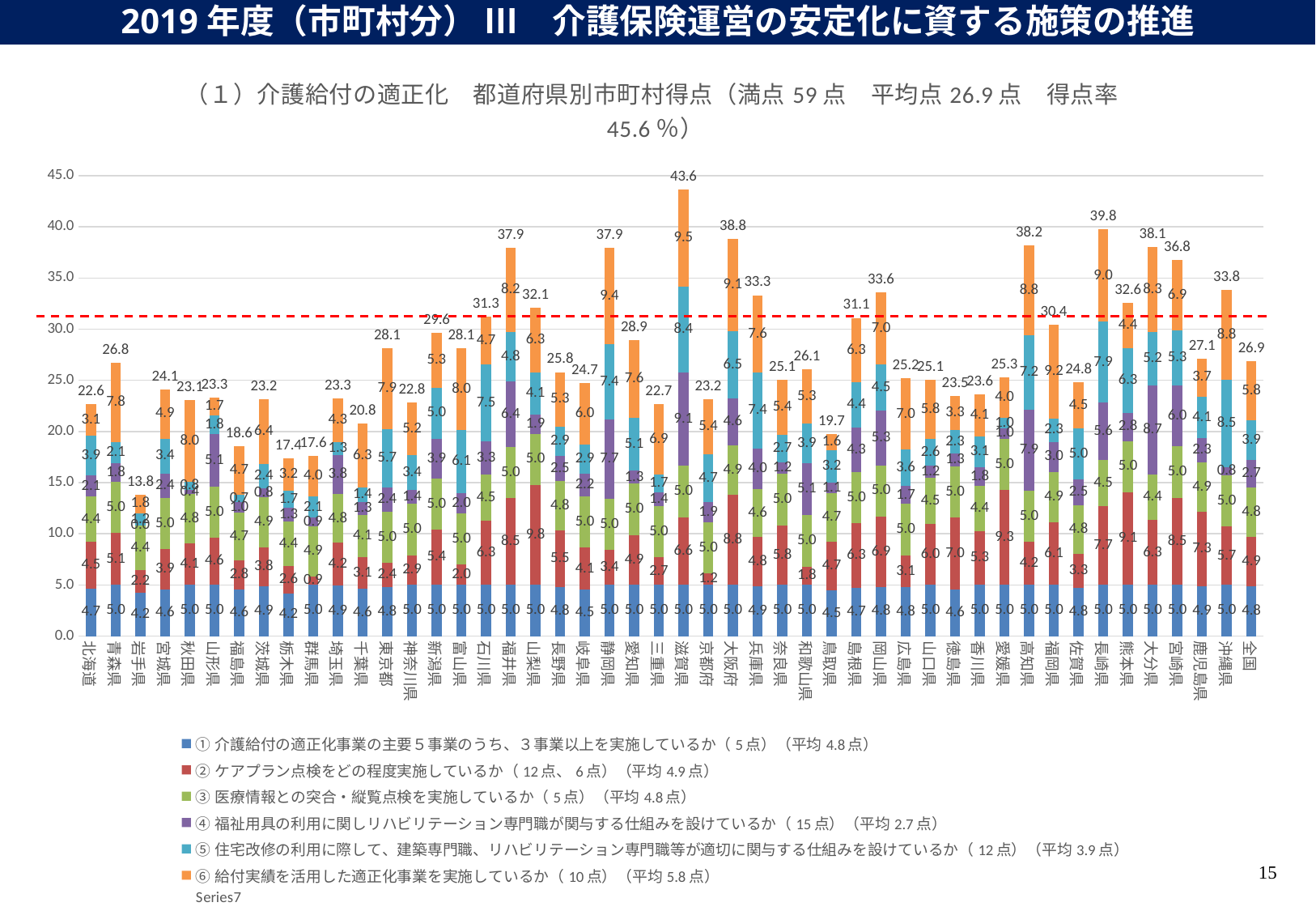
What kind of chart is shown on the slide? stacked bar chart What is the difference between the total scores of 滋賀県 and 全国? 16.7 Which prefecture has the lowest total score? 岩手県 Is the total score for 岩手県 greater or less than 15.0? less What is the total score shown for 全国? 26.9 What is the total score shown for 長崎県? 39.8 How many bars (categories) are shown on the x axis, including 全国? 48 What is the total score shown for 滋賀県? 43.6 Which prefecture has the highest total score? 滋賀県 According to the chart title, what is the average score (平均点)? 26.9 点 What is the value of the orange (⑥) segment for 全国? 5.8 Which has a higher total score, 福井県 or 大阪府? 大阪府